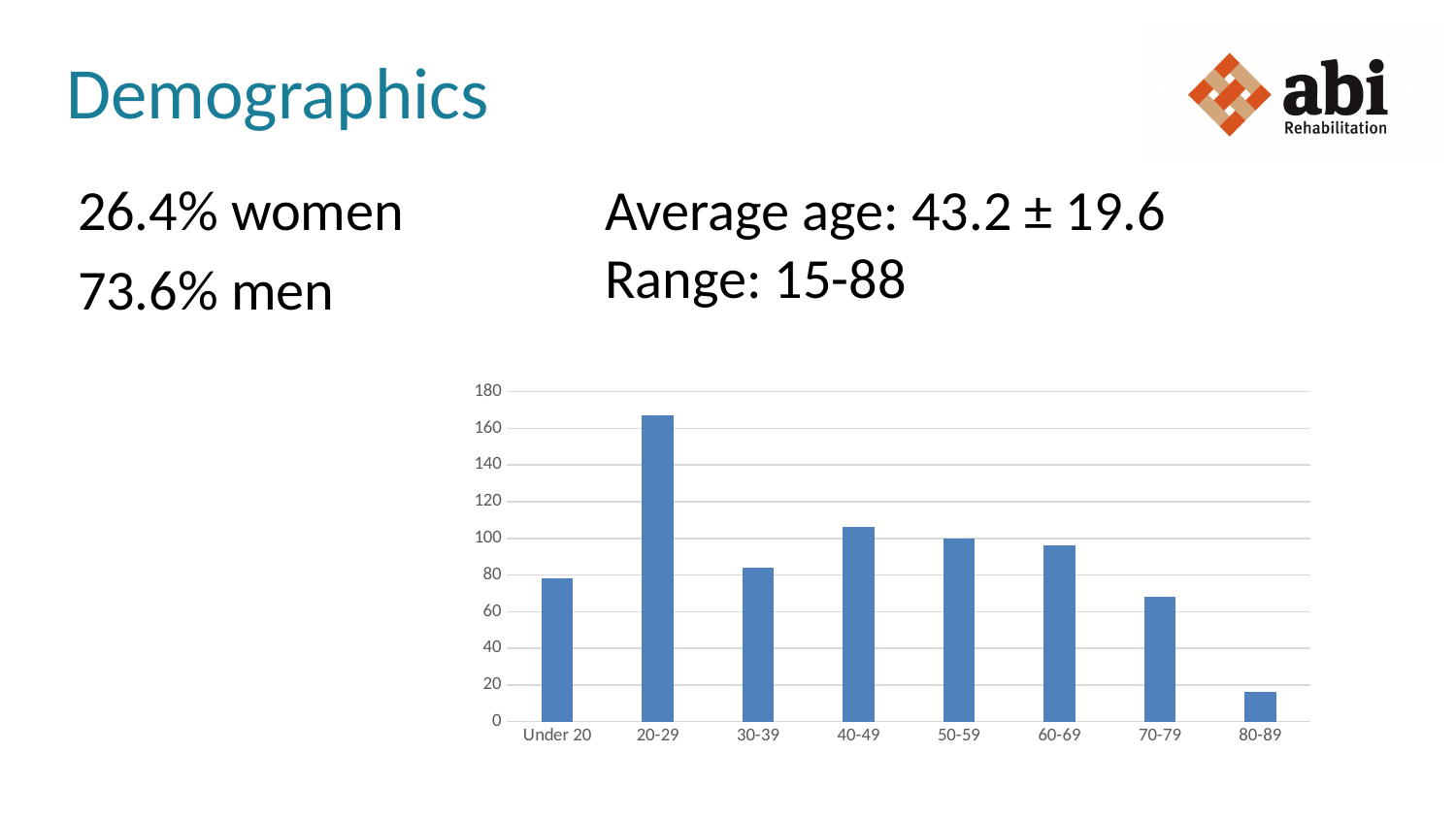
Is the value for 70-79 greater or less than 80? less Which age category has the highest bar in the chart? 20-29 Is the value for Under 20 greater or less than 60? greater Which is larger, the value for Under 20 or the value for 70-79? Under 20 How many age categories are shown on the x axis of the chart? 8 What kind of chart is shown on the slide? bar chart Which is larger, the value for 40-49 or the value for 60-69? 40-49 Which age category has the lowest bar in the chart? 80-89 Is the value for 40-49 greater or less than 100? greater Do the bars rise or fall from 40-49 through 80-89? fall